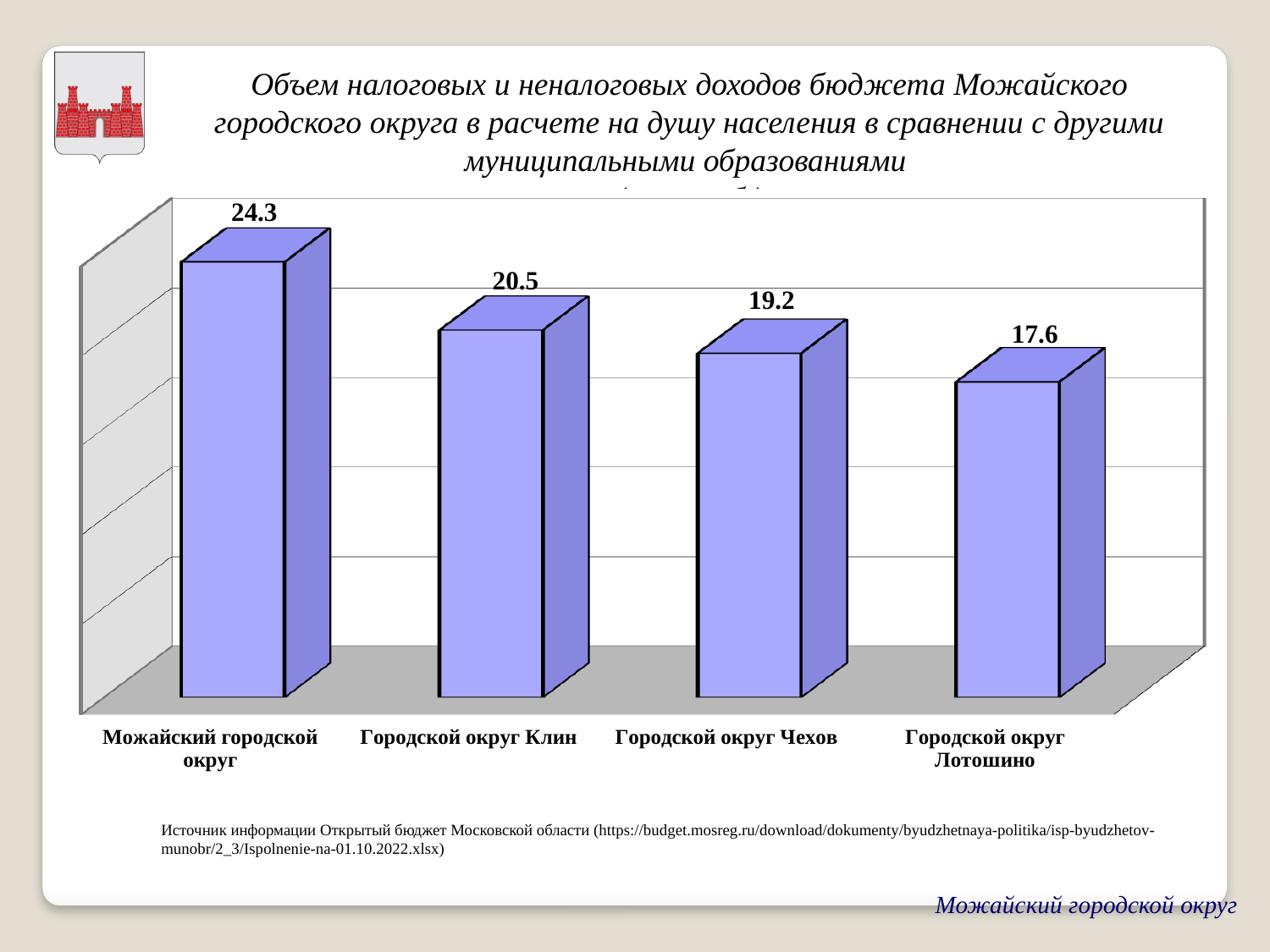
Which category has the lowest value? Городской округ Лотошино What is the value for Городской округ Лотошино? 17.6 What kind of chart is shown on the slide? Bar chart What is the difference between the values for Городской округ Клин and Городской округ Чехов? 1.3 What is the difference between the values for Можайский городской округ and Городской округ Лотошино? 6.7 What is the value for Можайский городской округ? 24.3 What is the value for Городской округ Чехов? 19.2 Which category has the highest value? Можайский городской округ Do the values rise or fall from left to right across the categories? Fall Which is larger, the value for Городской округ Клин or the value for Городской округ Лотошино? Городской округ Клин What is the value for Городской округ Клин? 20.5 How many categories are shown in the chart? 4